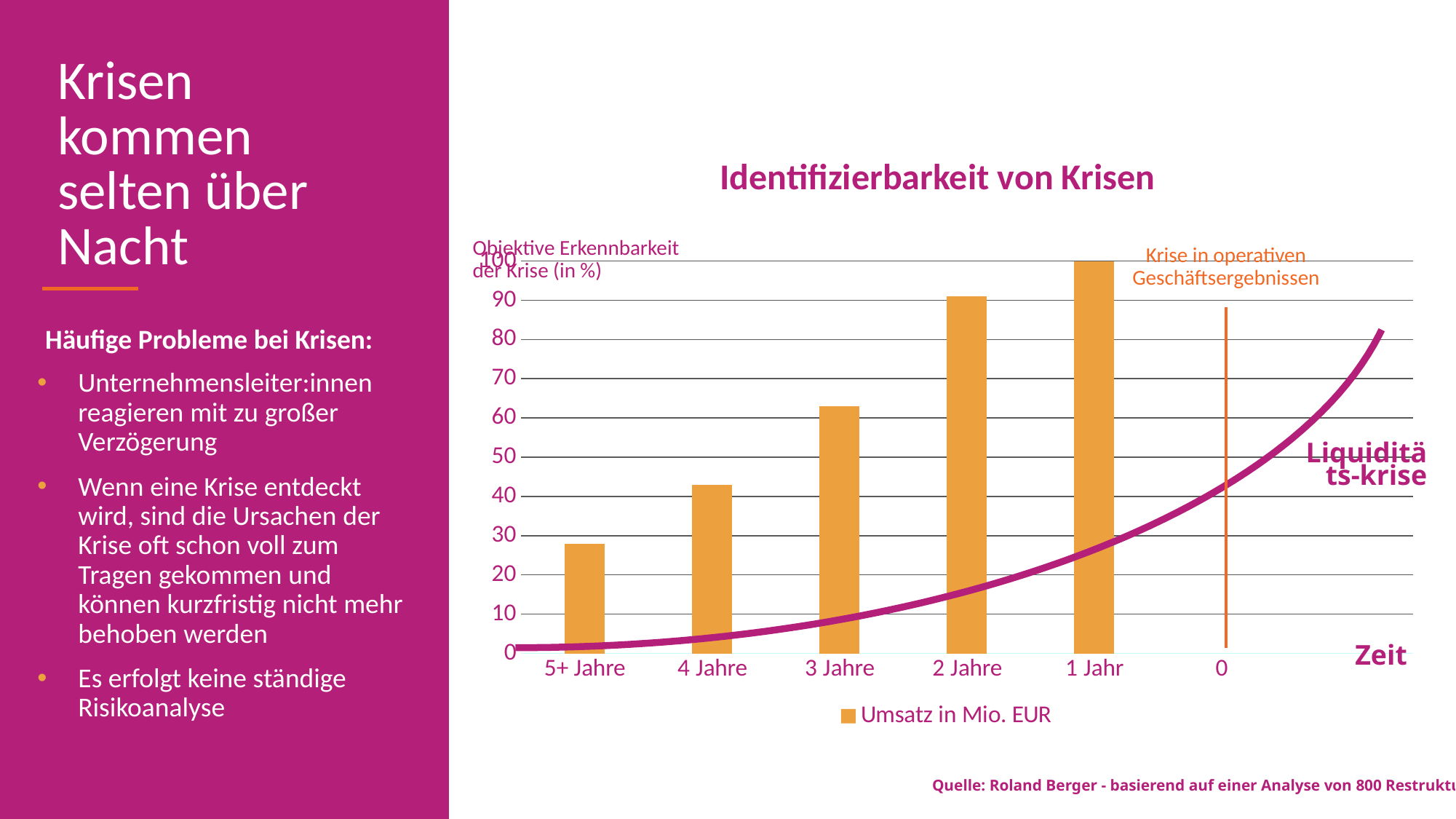
What kind of chart is shown on the slide? bar chart Is the value for 5+ Jahre greater or less than 30? less How many series does the legend list? 1 What is the title of the chart? Identifizierbarkeit von Krisen How many bars are plotted in the chart? 5 What entry does the chart legend list? Umsatz in Mio. EUR Is the value for 3 Jahre greater or less than 60? greater Which category has the lowest bar? 5+ Jahre Do the bar values rise or fall from left to right along the x axis? rise Which category has the highest bar? 1 Jahr What is the value of the bar for 1 Jahr? 100 Which bar is taller, 3 Jahre or 4 Jahre? 3 Jahre